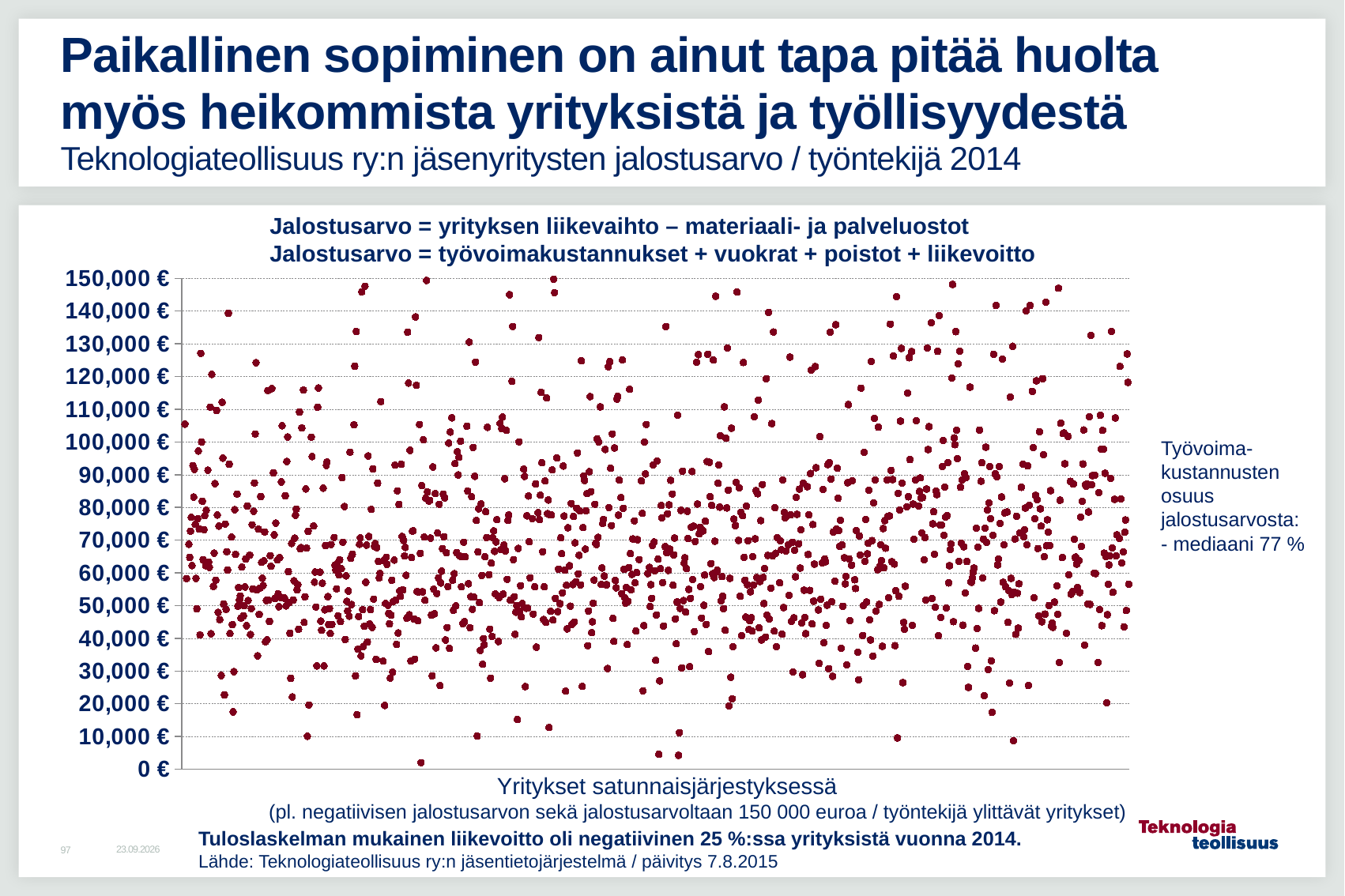
What is the median share of labour costs of value added stated next to the chart? 77 % Is the highest plotted point on the chart greater or less than 140,000 €? greater What is the label of the chart's x axis? Yritykset satunnaisjärjestyksessä Do the plotted values show a clear rising or falling trend along the x axis? no clear trend What is the highest value shown on the chart's y axis? 150,000 € What kind of chart is shown on the slide? scatter chart Is the lowest plotted point on the chart greater or less than 10,000 €? less